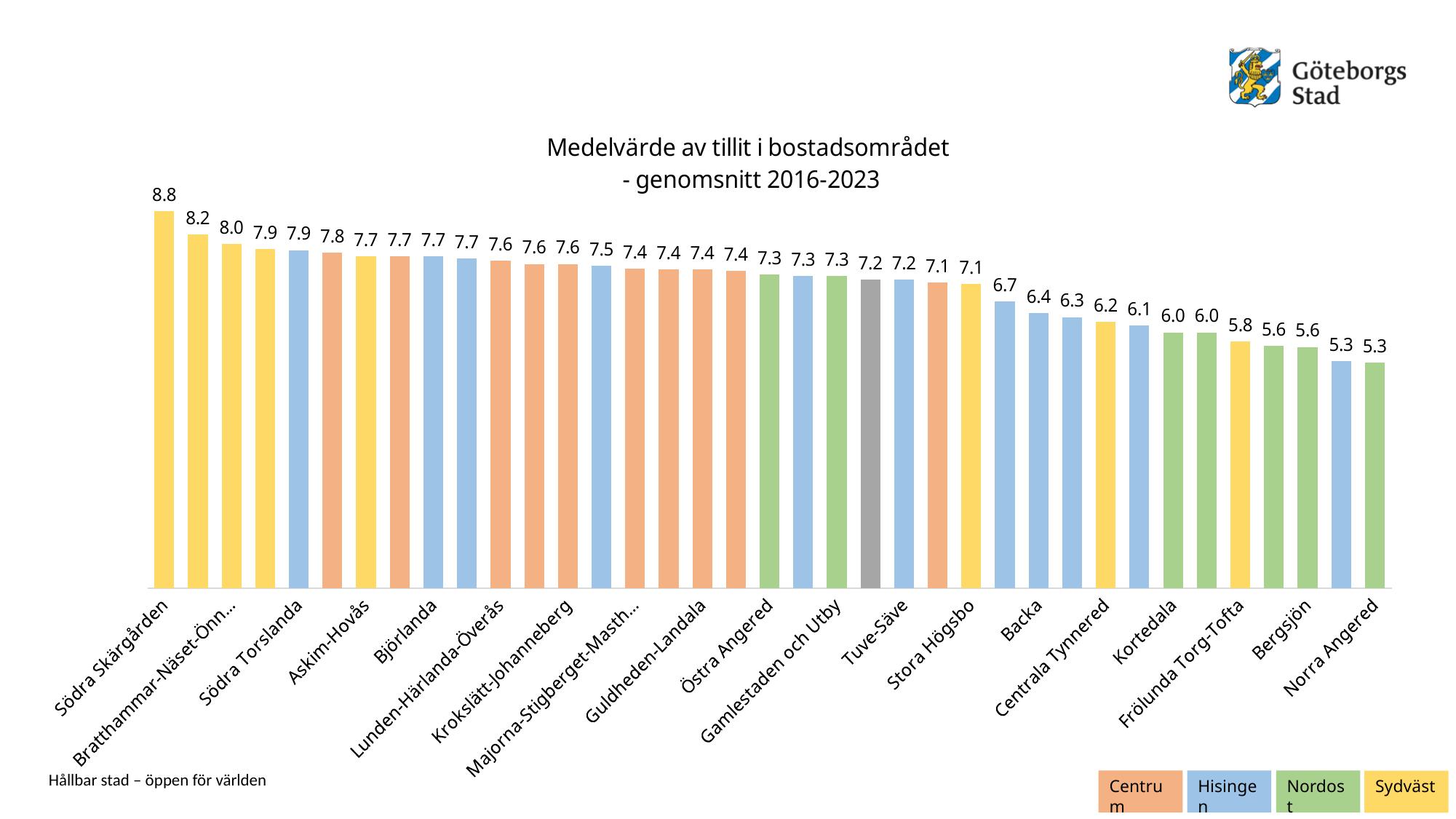
What is the value for Bergsjön? 5.6 What is the title of the chart? Medelvärde av tillit i bostadsområdet - genomsnitt 2016-2023 What is the value for Kortedala? 6.0 Do the values rise or fall from left to right along the x axis? fall What kind of chart is shown on the slide? bar chart What is the value for Tuve-Säve? 7.2 What is the value for Södra Skärgården? 8.8 What is the difference between the values for Södra Skärgården and Norra Angered? 3.5 Which has a higher value, Backa or Kortedala? Backa Which area has the highest value in the chart? Södra Skärgården How many entries does the legend list? 4 What is the value for Norra Angered? 5.3